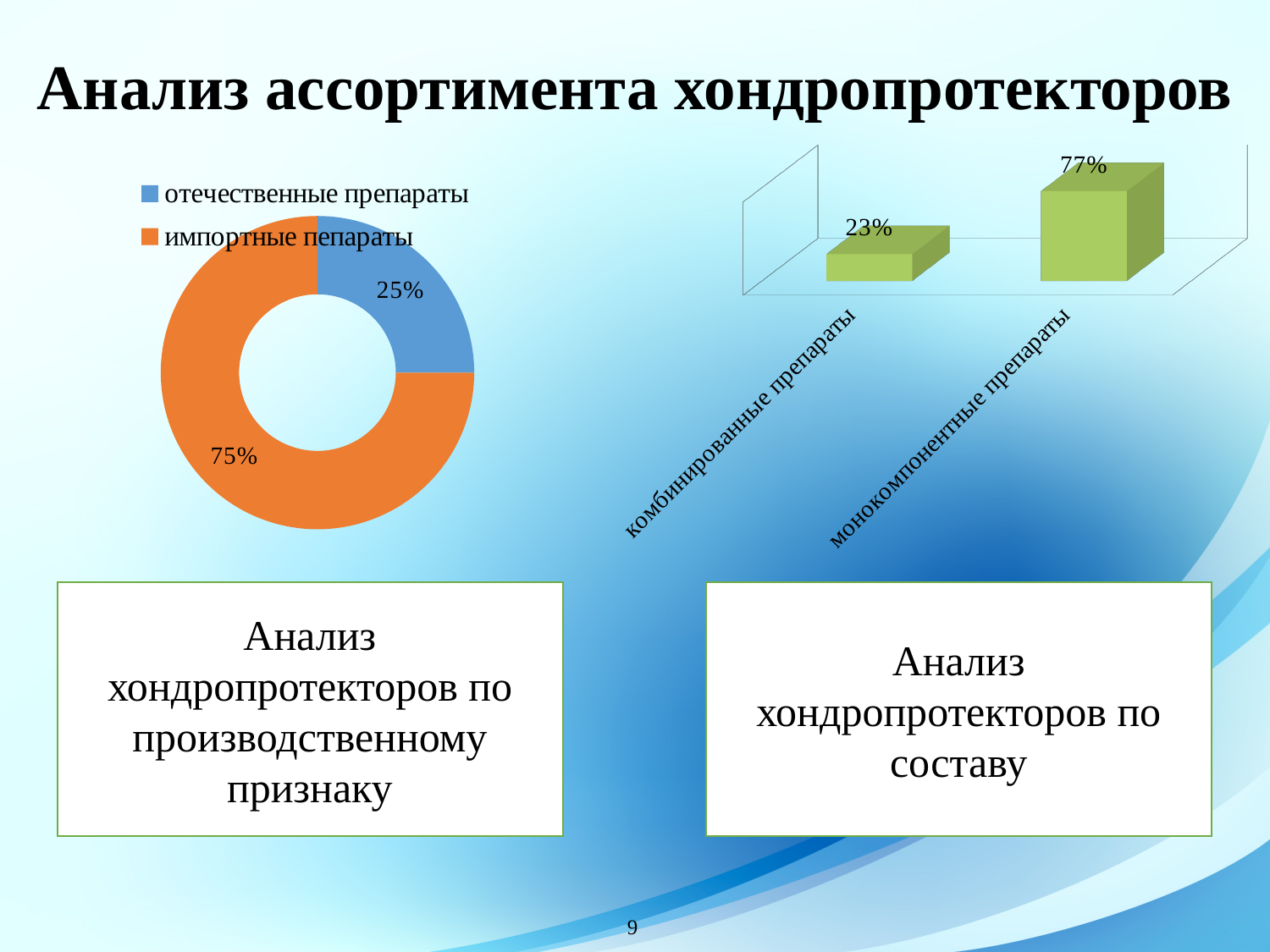
What kind of chart is the left chart on the slide? doughnut chart In the right chart (bar chart), how many categories are shown? 2 In the left chart (doughnut), what share is labelled for импортные пепараты? 75% In the left chart (doughnut), what share is labelled for отечественные препараты? 25% In the left chart (doughnut), how many entries does the legend list? 2 In the right chart (bar chart), what value is labelled for монокомпонентные препараты? 77% In the right chart (bar chart), what value is labelled for комбинированные препараты? 23% In the left chart (doughnut), what is the difference between the shares of импортные пепараты and отечественные препараты? 50% In the right chart (bar chart), what is the difference between монокомпонентные препараты and комбинированные препараты? 54% In the left chart (doughnut), what colour is the slice for отечественные препараты? blue In the right chart (bar chart), which category has the highest value? монокомпонентные препараты In the left chart (doughnut), which category has the larger share? импортные пепараты